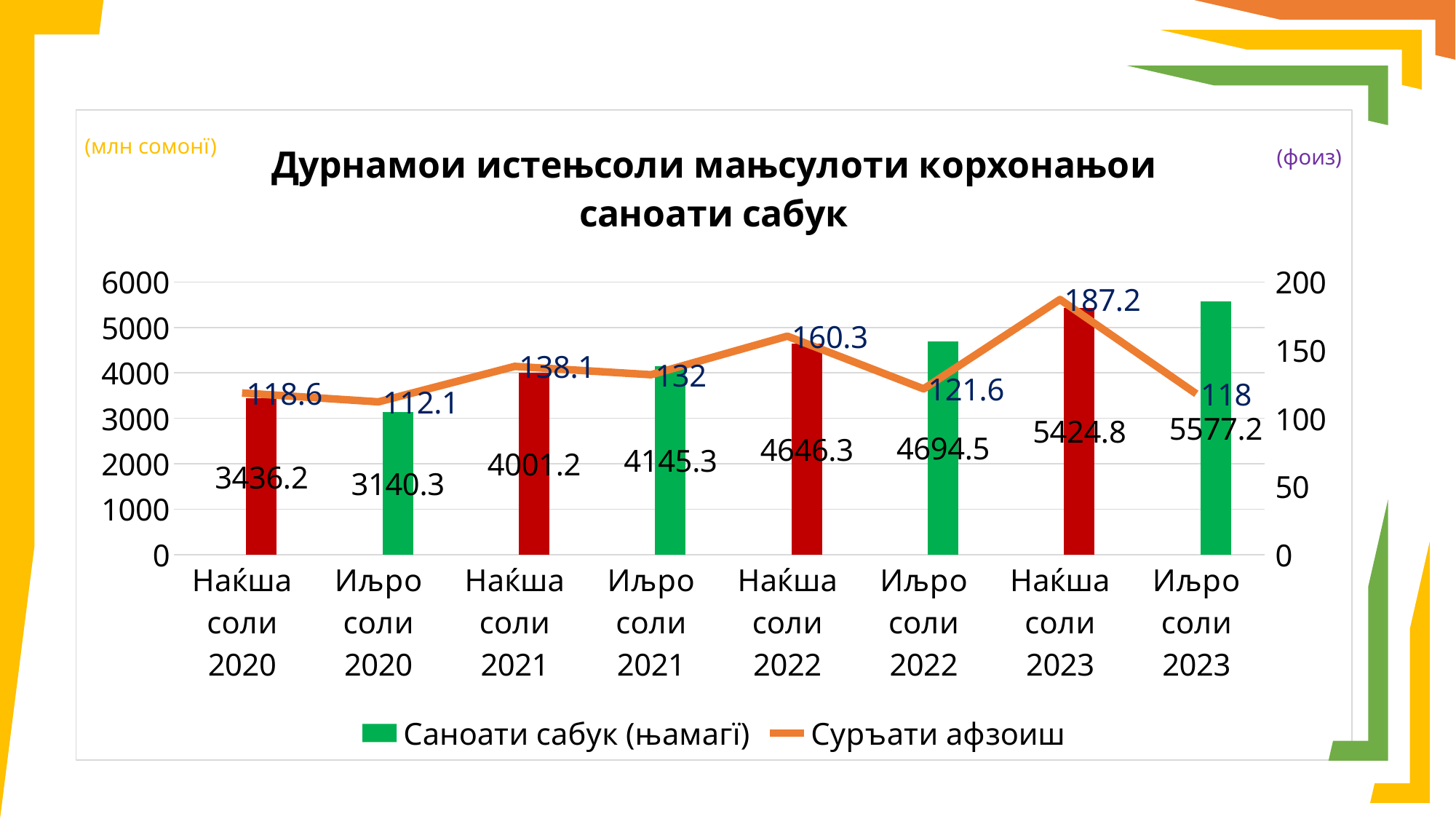
What is the difference between the Саноати сабук (њамагї) values for Иљро соли 2023 and Наќша соли 2023? 152.4 Which category has the lowest value of Саноати сабук (њамагї)? Иљро соли 2020 What is the value of Саноати сабук (њамагї) for Иљро соли 2023? 5577.2 What is the value of Суръати афзоиш for Наќша соли 2023? 187.2 How many series does the legend list? 2 Which is larger, the Суръати афзоиш value for Наќша соли 2022 or for Иљро соли 2022? Наќша соли 2022 How many categories are shown on the x axis? 8 What is the value of Саноати сабук (њамагї) for Наќша соли 2021? 4001.2 What is the title of the chart? Дурнамои истењсоли мањсулоти корхонањои саноати сабук Do the Саноати сабук (њамагї) values generally rise or fall from 2020 to 2023? Rise What kind of chart is this? Combined bar and line chart Which category has the highest value of Суръати афзоиш? Наќша соли 2023